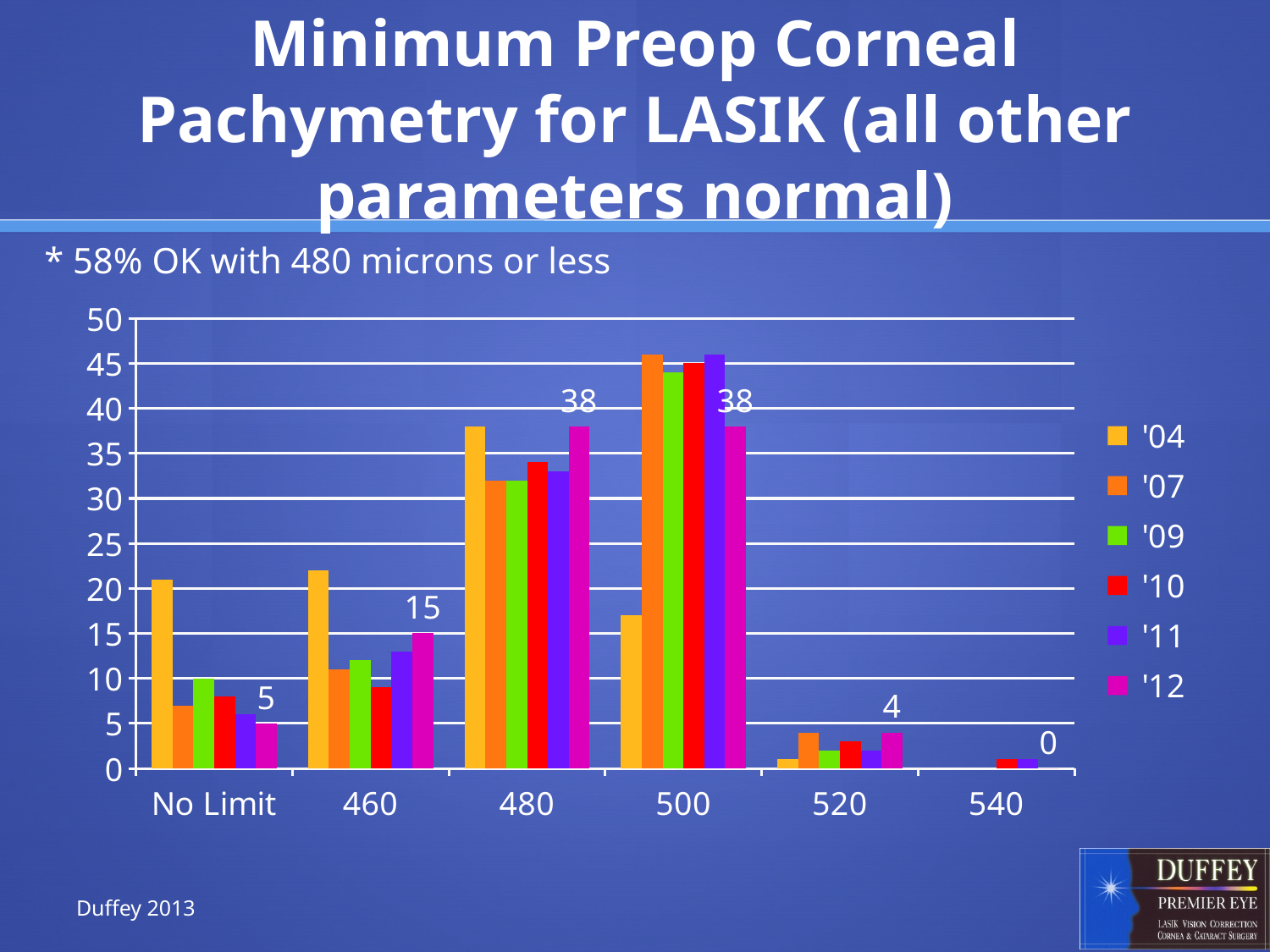
What kind of chart is shown on the slide? bar chart Is the value for the '07 series at 500 greater or less than 40? greater How many series does the legend list? 6 Which is larger for the '12 series: the value at 460 or the value at 520? 460 Which category has the lowest value for the '12 series? 540 How many categories are shown on the x axis? 6 What is the value for the '12 series at No Limit? 5 What is the value for the '12 series at 460? 15 What is the difference between the '12 values at 480 and 460? 23 What is the value for the '12 series at 480? 38 Is the value for the '04 series at 500 greater or less than 20? less What is the value for the '12 series at 520? 4